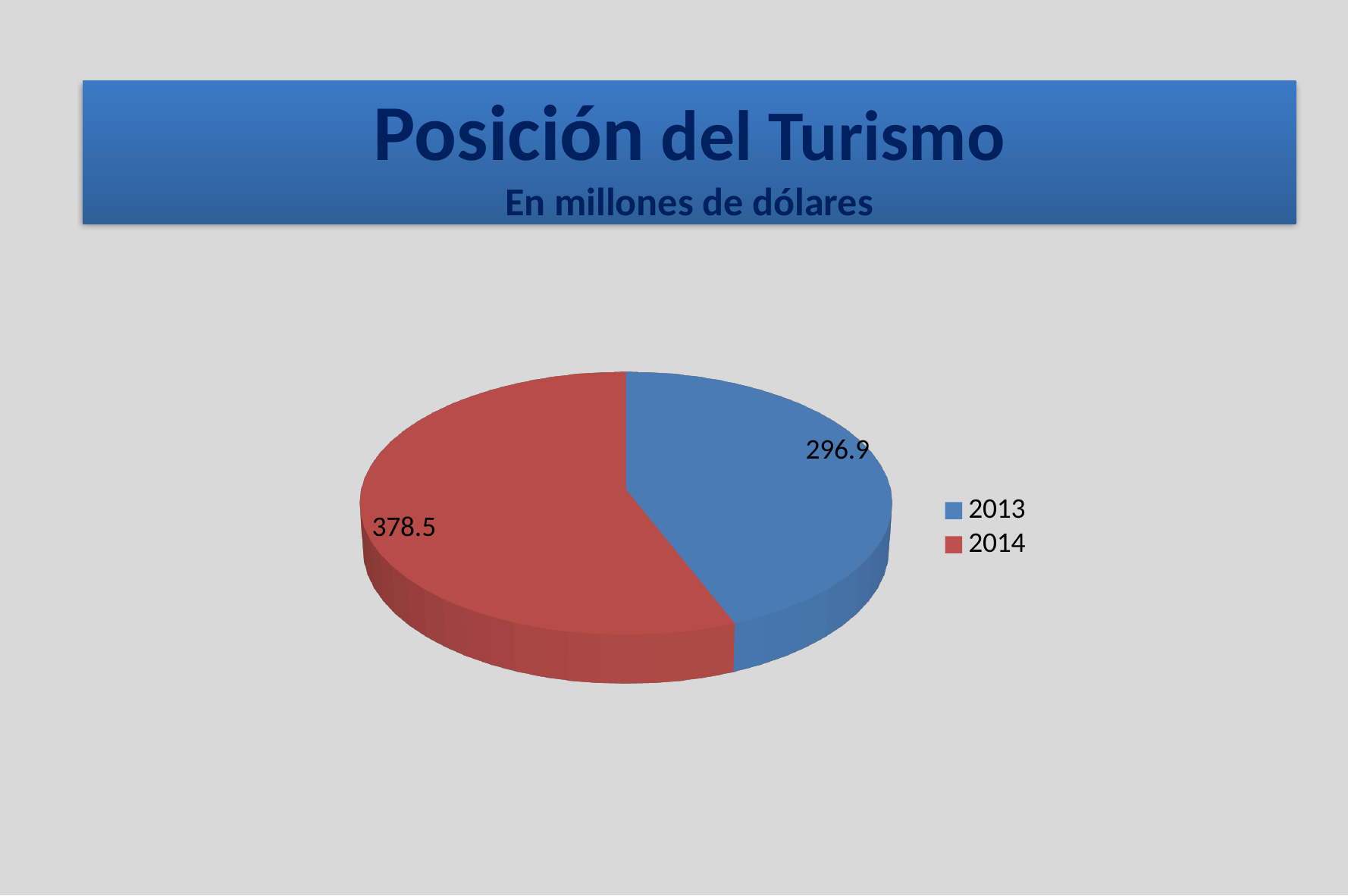
What kind of chart is shown on the slide? pie chart What is the value for 2013 in the pie chart? 296.9 What is the difference between the 2014 value and the 2013 value? 81.6 Which year has the smaller slice in the pie chart? 2013 Which year has the larger slice in the pie chart? 2014 How many slices does the pie chart have? 2 What colour is the slice for 2014? red What is the value for 2014 in the pie chart? 378.5 What is the total of the two values shown in the pie chart? 675.4 How many entries does the legend list? 2 Is the value for 2013 larger or smaller than the value for 2014? smaller